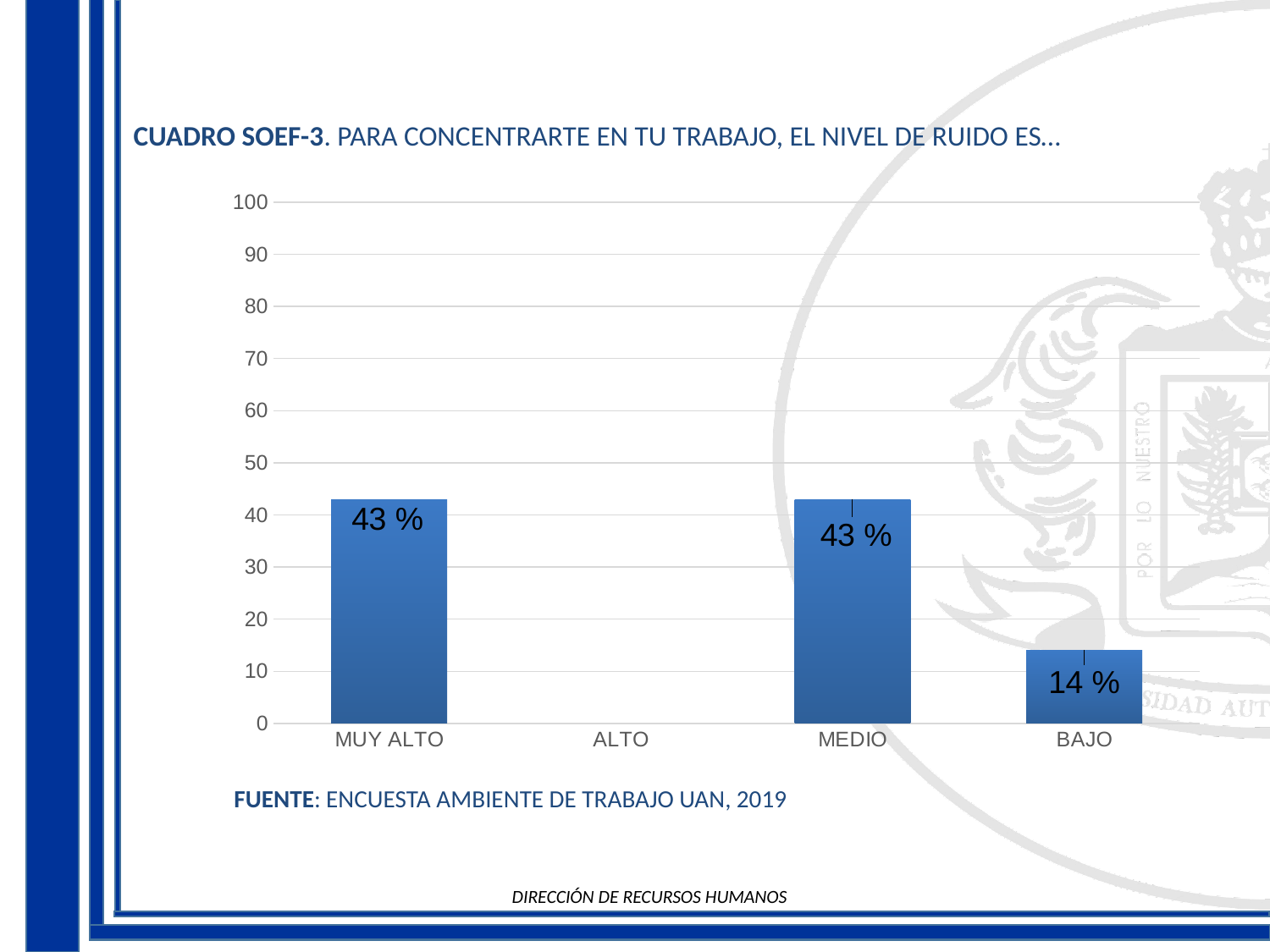
Which is larger, the value for MEDIO or the value for BAJO? MEDIO Is the value for MUY ALTO greater or less than 40? greater What is the value for BAJO? 14 % What is the value for MEDIO? 43 % What source is cited below the chart? ENCUESTA AMBIENTE DE TRABAJO UAN, 2019 What is the value for MUY ALTO? 43 % What is the maximum value shown on the y axis? 100 Which category has the lowest value among the bars with data labels? BAJO What is the difference between the values for MUY ALTO and BAJO? 29 % How many categories are shown on the x axis? 4 What kind of chart is shown on the slide? bar chart Is the value for BAJO greater or less than 20? less